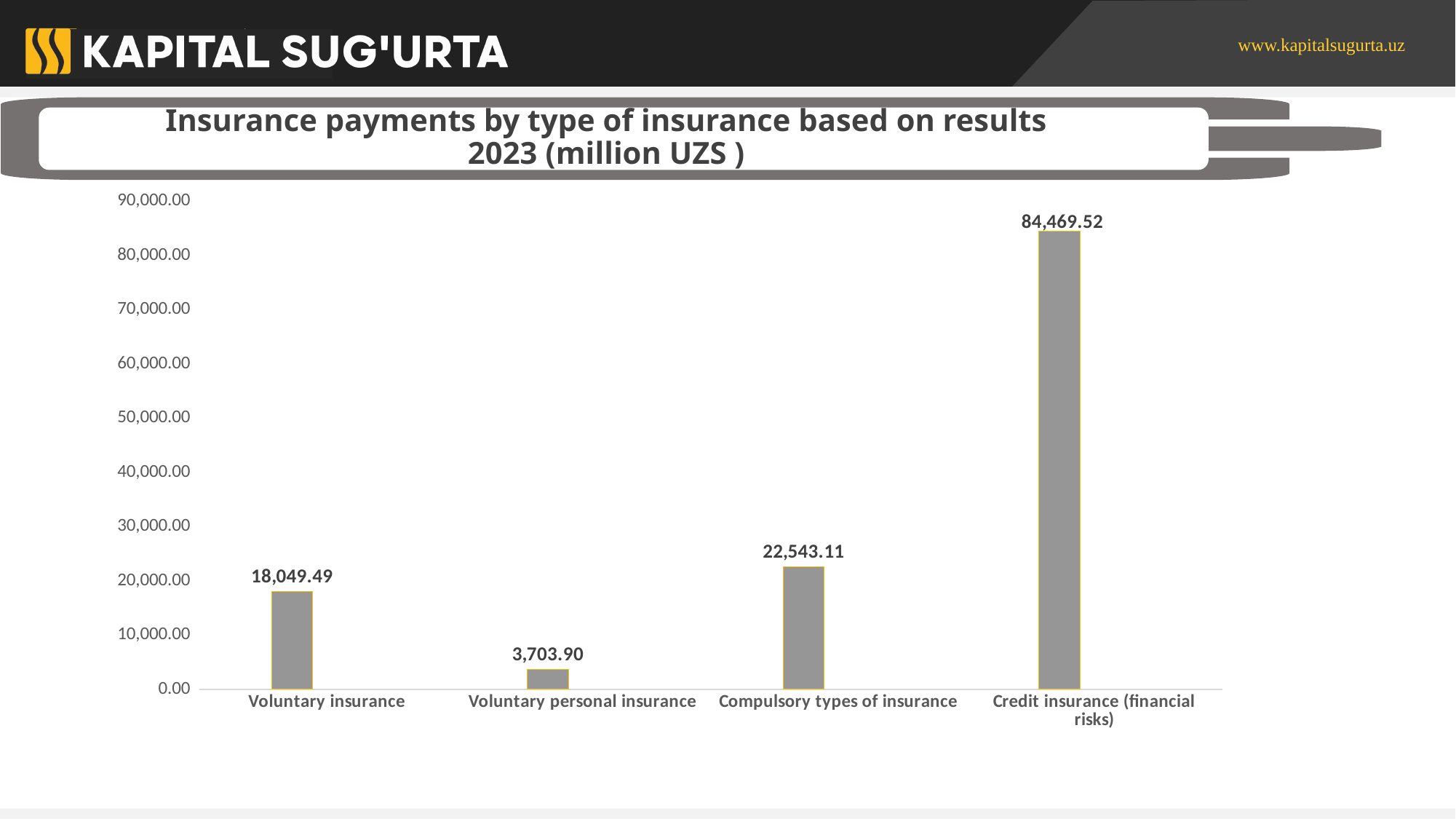
What is the value for Voluntary insurance? 18,049.49 Which type of insurance has the highest insurance payments? Credit insurance (financial risks) What is the difference between Credit insurance (financial risks) and Compulsory types of insurance? 61,926.41 Is the value for Voluntary insurance greater or less than 20,000.00? less Which is larger, Voluntary insurance or Compulsory types of insurance? Compulsory types of insurance How many types of insurance are shown on the chart? 4 Which type of insurance has the lowest insurance payments? Voluntary personal insurance What is the difference between Compulsory types of insurance and Voluntary insurance? 4,493.62 What is the value for Voluntary personal insurance? 3,703.90 What is the value for Compulsory types of insurance? 22,543.11 What kind of chart is shown on the slide? Bar chart What is the value for Credit insurance (financial risks)? 84,469.52